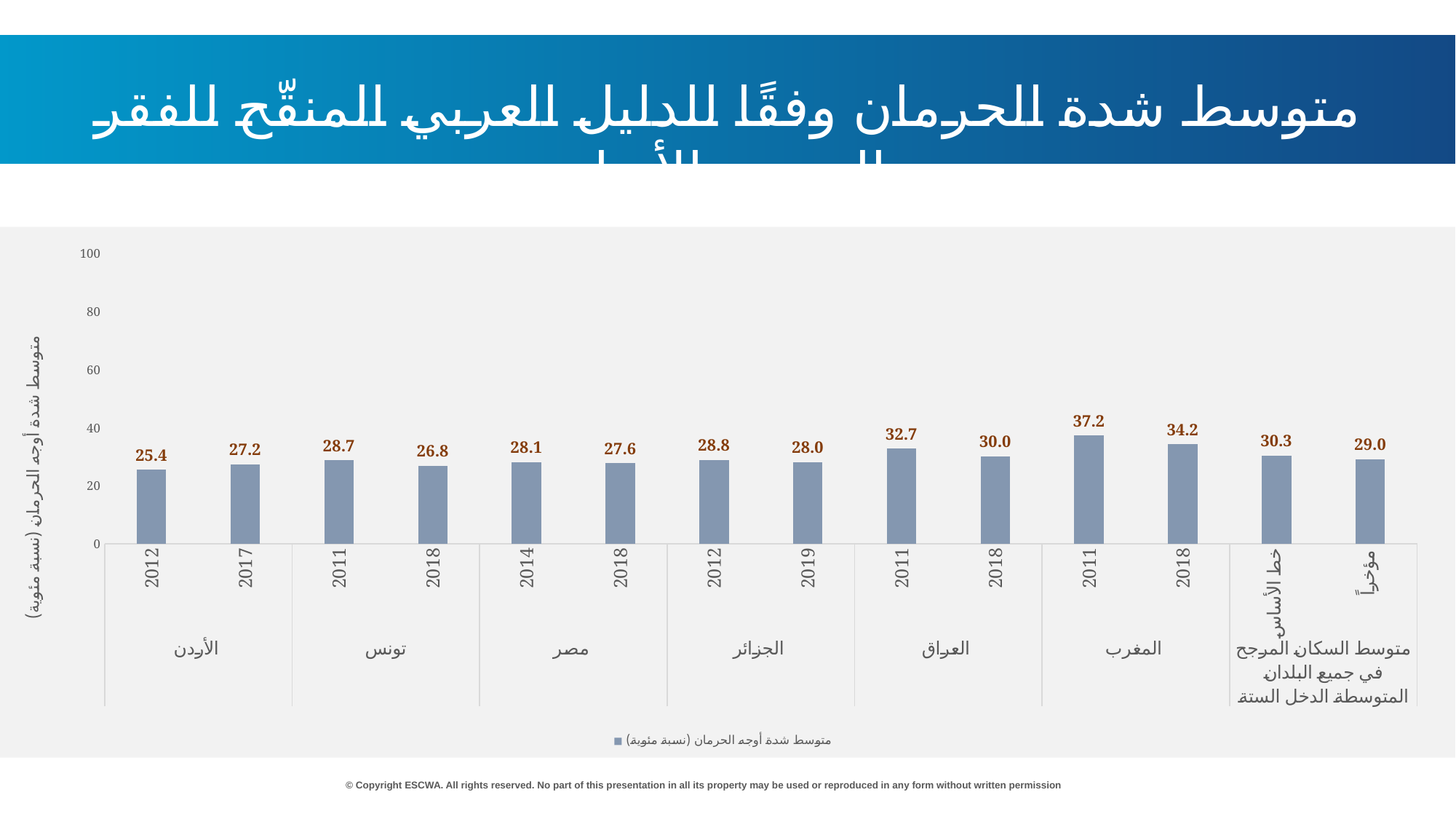
Which bar has the highest value on the chart? المغرب (Morocco) 2011 What is the value for العراق (Iraq) in 2018? 30.0 What is the value for the weighted population average of the six middle-income countries at خط الأساس (baseline)? 30.3 What is the value for المغرب (Morocco) in 2011? 37.2 Is the value for العراق (Iraq) in 2011 greater or less than 40? less Which bar has the lowest value on the chart? الأردن (Jordan) 2012 What is the value for الأردن (Jordan) in 2012? 25.4 How many bars are plotted on the chart? 14 How many series does the legend list? 1 What is the difference between the 2011 and 2018 values for المغرب (Morocco)? 3.0 What kind of chart is shown on the slide? bar chart Which is larger: the value for تونس (Tunisia) in 2011 or in 2018? 2011